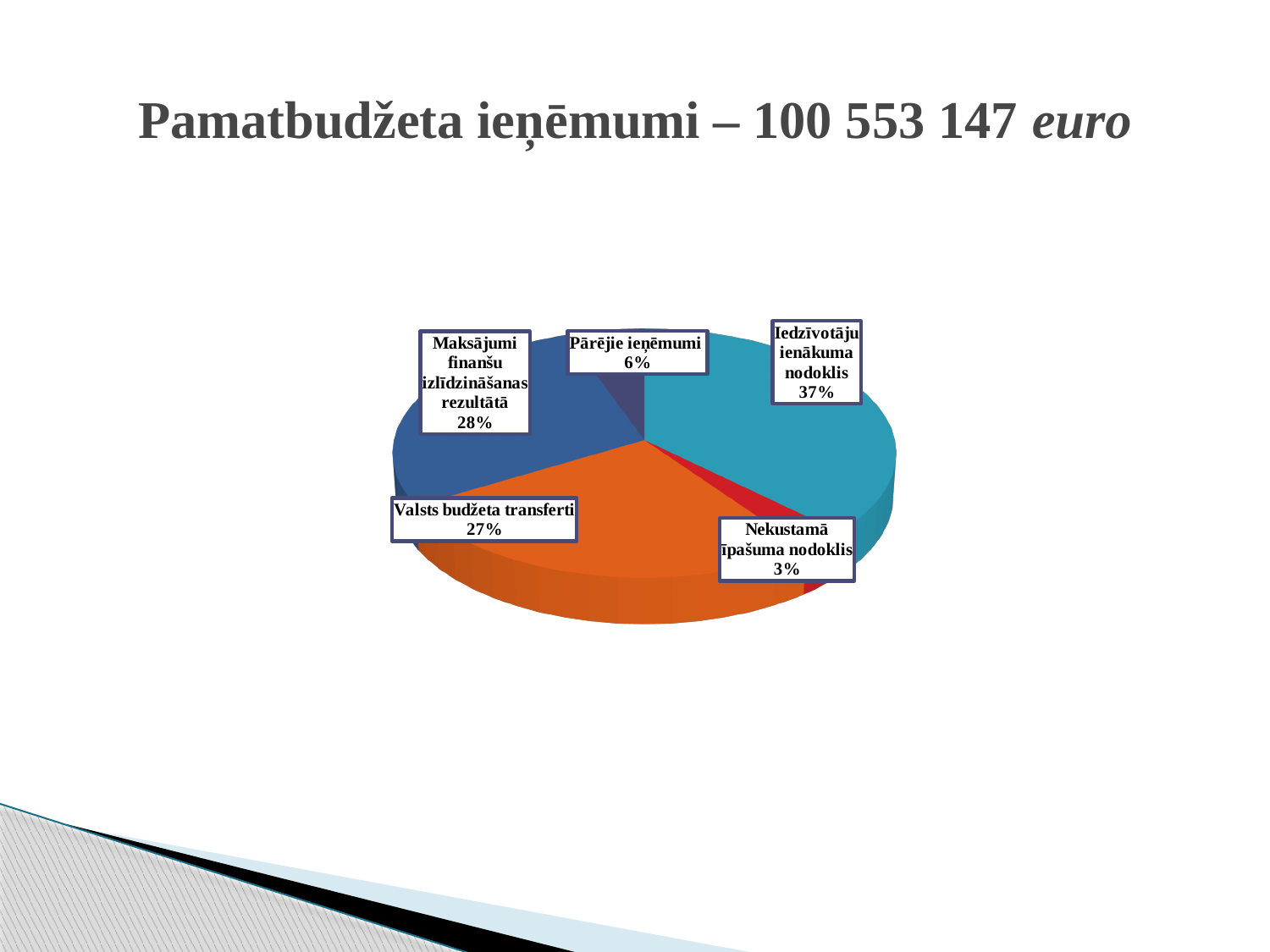
What kind of chart is shown on the slide? pie chart What share of the pie does Nekustamā īpašuma nodoklis have? 3% What share of the pie does Valsts budžeta transferti have? 27% What share of the pie does Maksājumi finanšu izlīdzināšanas rezultātā have? 28% What is the title of the slide? Pamatbudžeta ieņēmumi – 100 553 147 euro Which category has the smallest share of the pie? Nekustamā īpašuma nodoklis Which is larger, Pārējie ieņēmumi or Nekustamā īpašuma nodoklis? Pārējie ieņēmumi What is the difference in percentage points between Iedzīvotāju ienākuma nodoklis and Valsts budžeta transferti? 10 Which category has the largest share of the pie? Iedzīvotāju ienākuma nodoklis How many slices does the pie chart have? 5